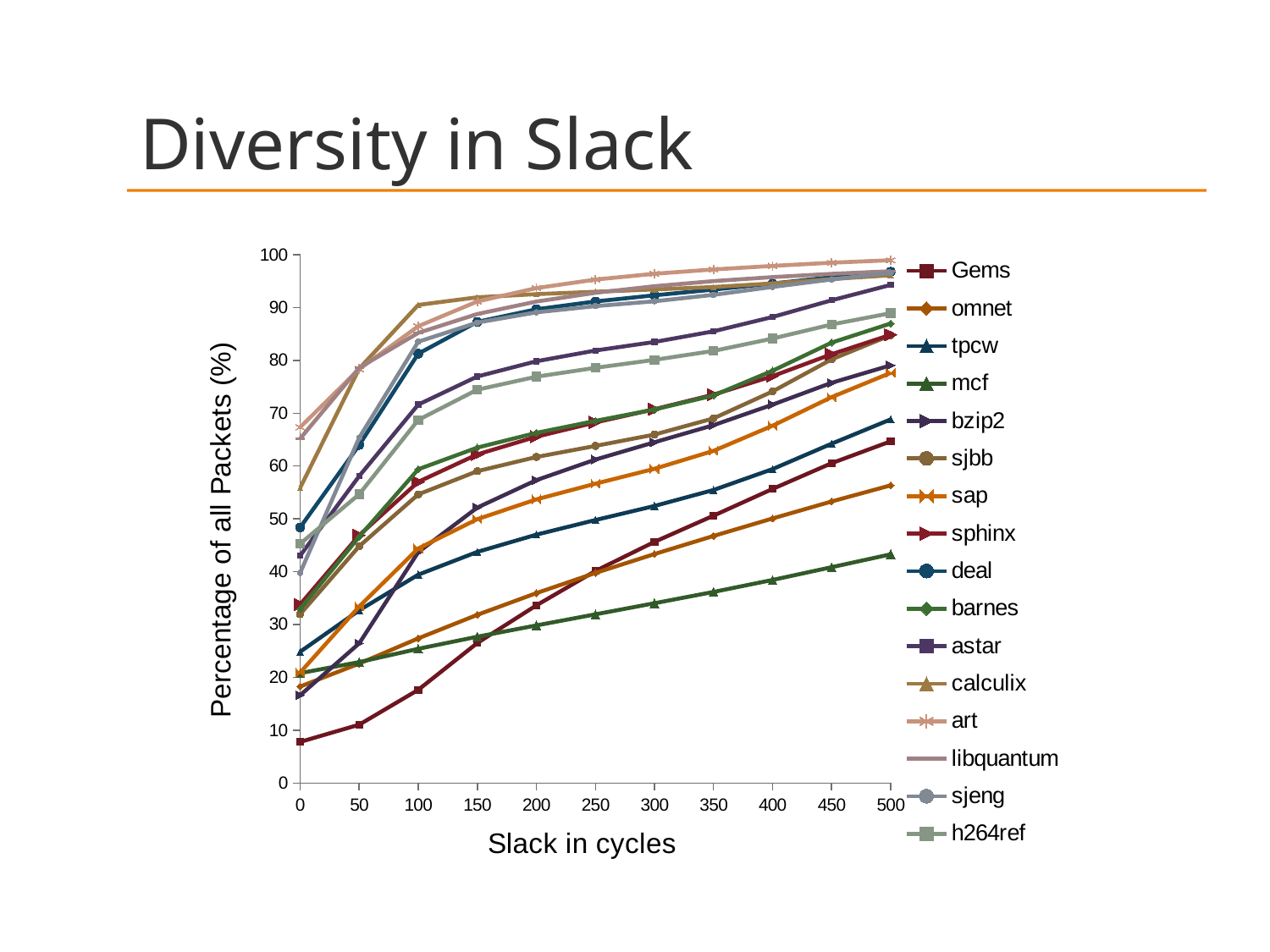
How many series does the legend list? 16 Which series has the lowest percentage of packets at a slack of 0 cycles? Gems Which series has the highest percentage of packets at a slack of 500 cycles? art How many slack values (x-axis points) are plotted for each series? 11 Is the value for Gems at a slack of 0 cycles greater or less than 10? less What kind of chart is shown on the slide? line chart Do the values for Gems rise or fall as slack increases along the x axis? rise What is the label of the y axis? Percentage of all Packets (%) Is the value for art at a slack of 500 cycles greater or less than 90? greater Is the value for mcf at a slack of 500 cycles greater or less than 50? less At a slack of 500 cycles, which is larger: the value for Gems or the value for mcf? Gems Which series has the lowest percentage of packets at a slack of 500 cycles? mcf